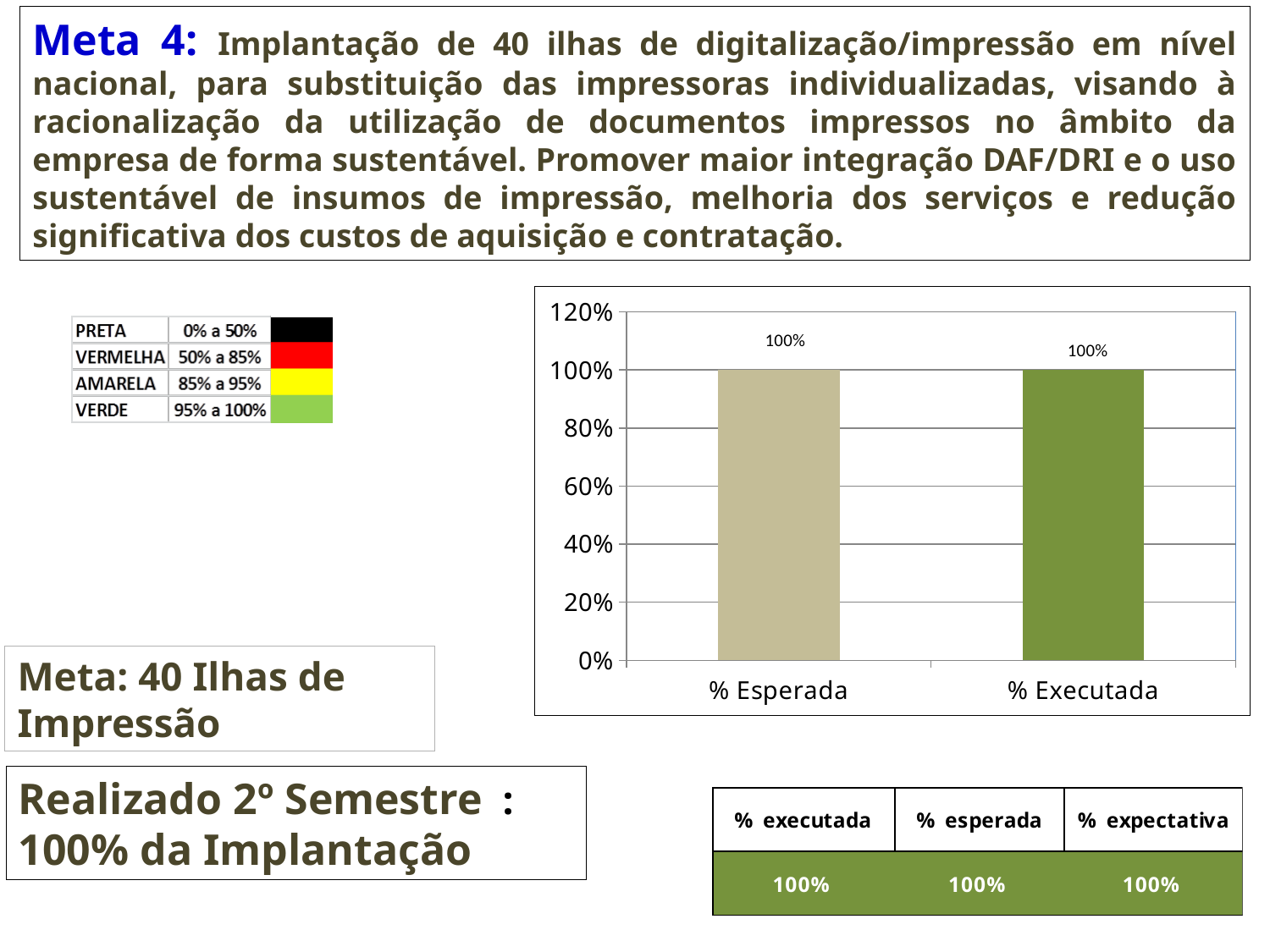
What is the difference between the values for % Esperada and % Executada? 0% How many categories are shown on the x axis of the chart? 2 What kind of chart is shown on the slide? bar chart What is the highest value shown on the y axis of the chart? 120% What is the value for % Esperada? 100% Is the value for % Esperada greater or less than 60%? greater Is the value for % Executada greater or less than 80%? greater What is the value for % Executada? 100% What is the label of the first category on the x axis of the chart? % Esperada